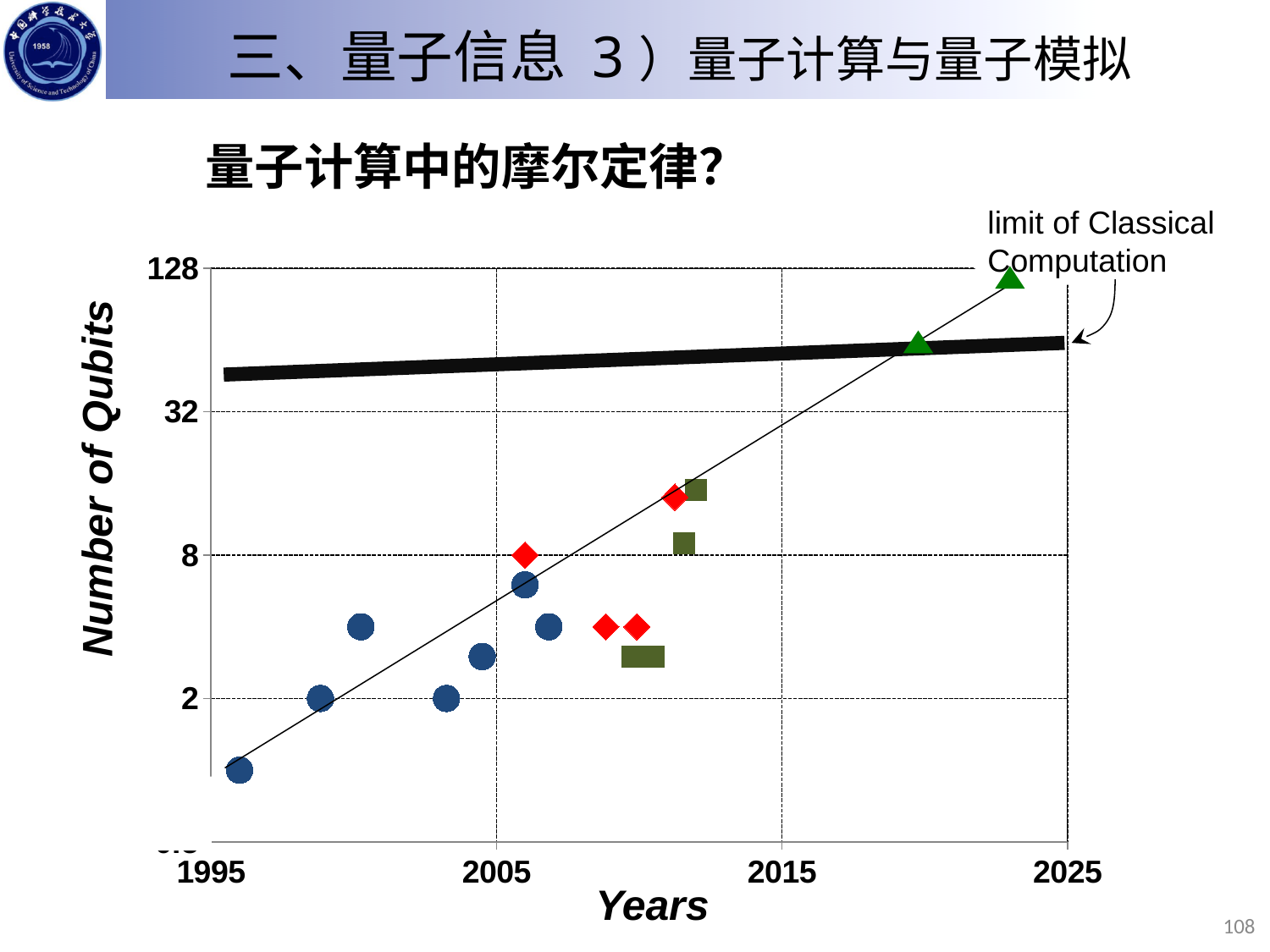
Do the plotted points generally rise or fall as the years increase along the x axis? rise Is the value of the blue circle plotted near 1996 greater or less than 2? less What is the title of the y axis of the chart? Number of Qubits What kind of chart is shown on the slide? scatter chart What is the highest value labelled on the y axis of the chart? 128 What is the title of the x axis of the chart? Years Is the value of the green triangle plotted near 2023 greater or less than 32? greater Is the value of the olive square plotted near 2012 greater or less than 32? less How many green triangle points are plotted on the chart? 2 What is the last year labelled on the x axis of the chart? 2025